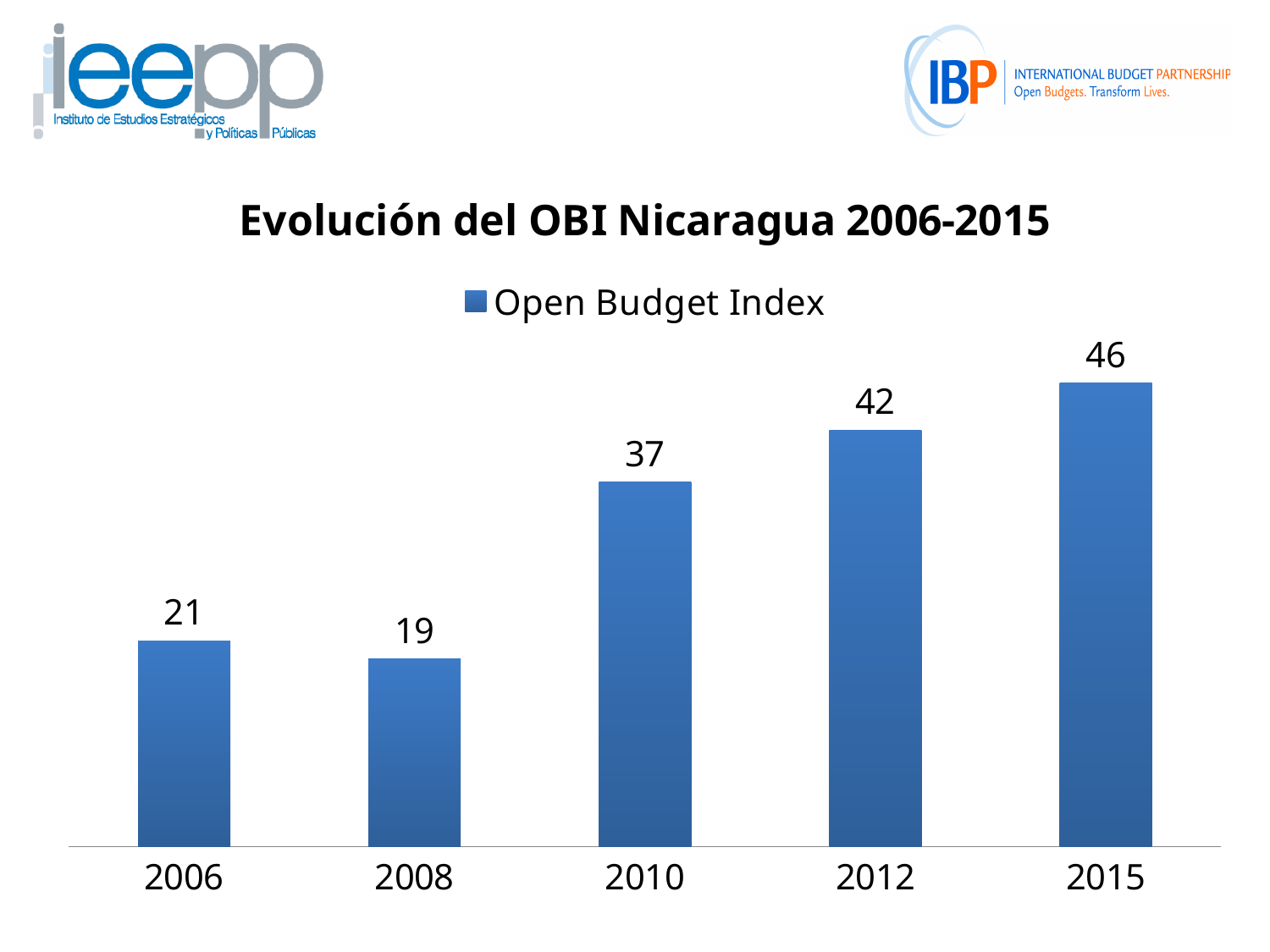
How many years are shown on the x axis of the chart? 5 What is the Open Budget Index value for 2015? 46 What is the difference between the Open Budget Index values for 2012 and 2010? 5 Which year has a larger Open Budget Index value, 2006 or 2008? 2006 What is the title of the chart? Evolución del OBI Nicaragua 2006-2015 Which year has the highest Open Budget Index value? 2015 What kind of chart is shown on the slide? Bar chart What is the Open Budget Index value for 2006? 21 What is the difference between the Open Budget Index values for 2015 and 2006? 25 Which year has the lowest Open Budget Index value? 2008 How many series does the legend list? 1 What is the Open Budget Index value for 2010? 37